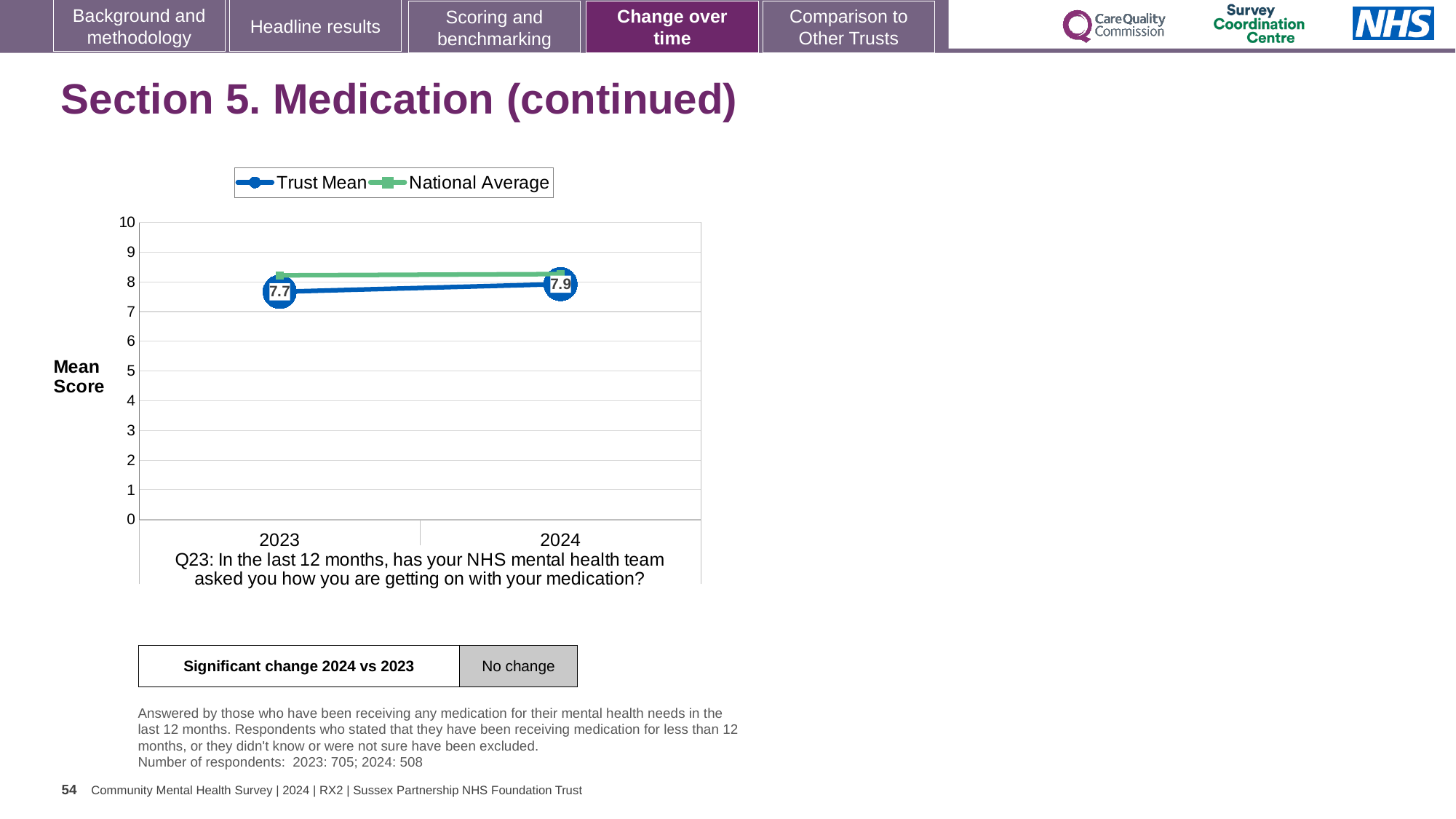
Which year has the higher Trust Mean, 2023 or 2024? 2024 How many series does the legend list? 2 What is the label on the y axis? Mean Score What is the Trust Mean score for 2023? 7.7 In 2023, which is higher: the Trust Mean or the National Average? National Average What kind of chart is shown? line chart How many years are plotted on the x axis? 2 What are the two series named in the legend? Trust Mean and National Average Does the Trust Mean rise or fall from 2023 to 2024? rise By how much did the Trust Mean change from 2023 to 2024? 0.2 What is the Trust Mean score for 2024? 7.9 Is the National Average value for 2023 greater or less than 8? greater